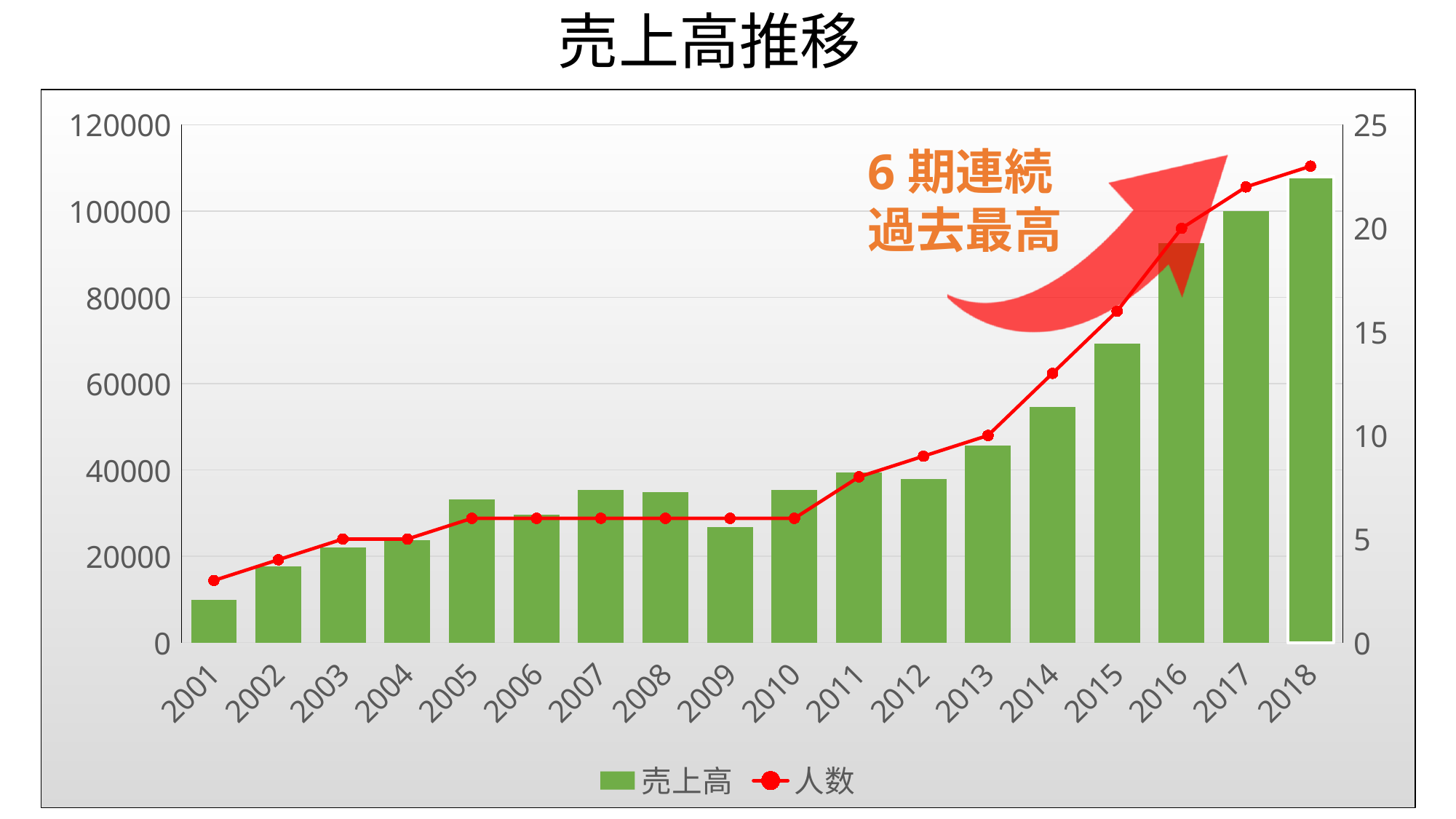
How many series does the legend list? 2 What kind of chart is shown on the slide? A combined bar and line chart Which year has the lowest 売上高 bar? 2001 Is the 売上高 value for 2001 greater or less than 20000? less Which year has the highest 売上高 bar? 2018 Which year has a larger 売上高 bar, 2013 or 2014? 2014 Is the 売上高 value for 2016 greater or less than 80000? greater What is the title of the chart? 売上高推移 Does the 人数 line generally rise or fall from 2001 to 2018? Rise Is the 人数 value for 2018 greater or less than 20? greater How many years are shown on the x axis? 18